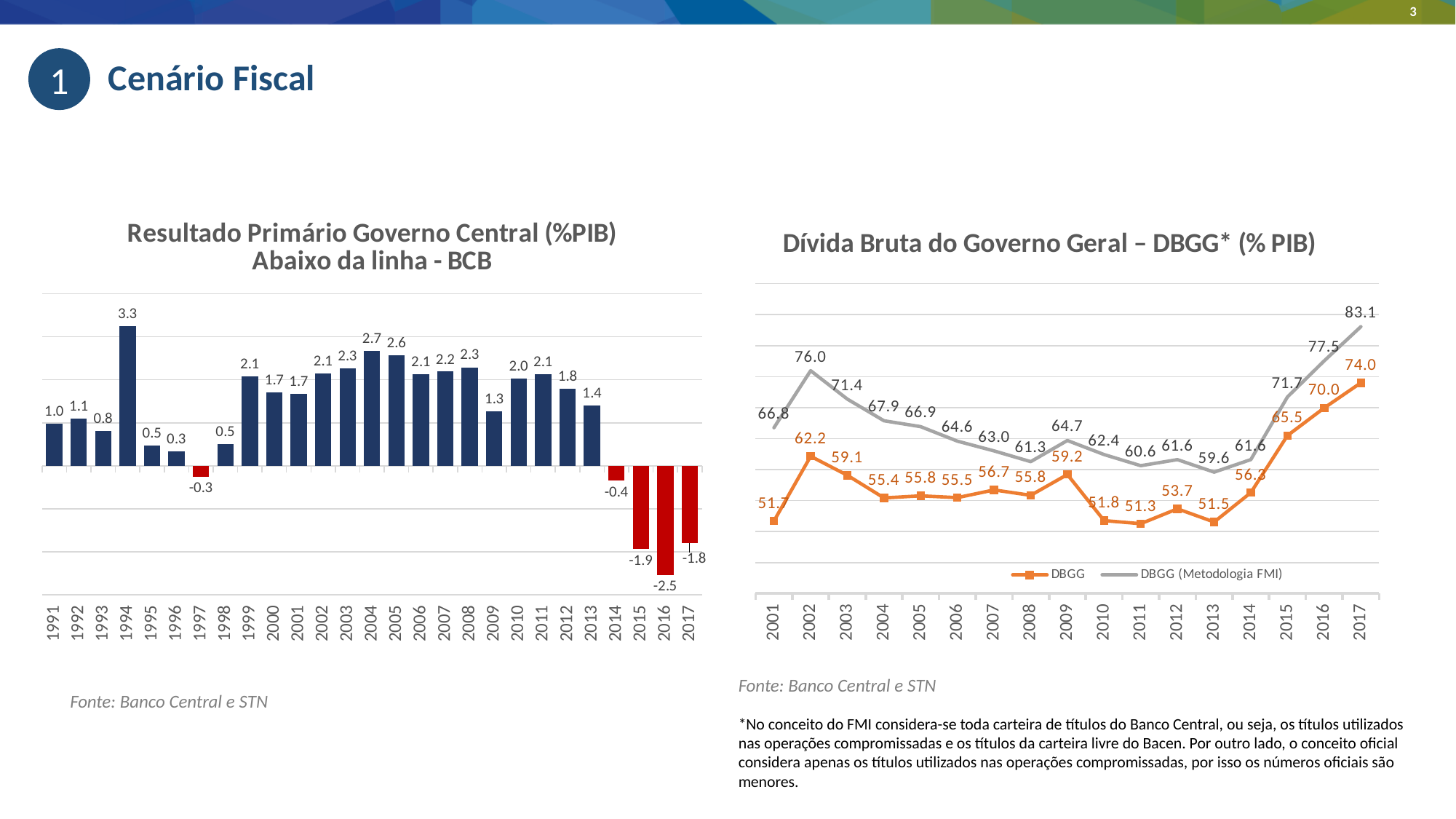
In the 'Resultado Primário Governo Central (%PIB)' chart, which year has the lowest value? 2016 In the 'Dívida Bruta do Governo Geral – DBGG* (% PIB)' chart, do the DBGG values rise or fall from 2013 to 2017? Rise In the 'Resultado Primário Governo Central (%PIB)' chart, what is the difference between the values for 2004 and 2013? 1.3 In the 'Resultado Primário Governo Central (%PIB)' chart, what is the value for 2016? -2.5 In the 'Dívida Bruta do Governo Geral – DBGG* (% PIB)' chart, what is the DBGG value for 2011? 51.3 What kind of chart is the 'Resultado Primário Governo Central (%PIB)' chart? Bar chart In the 'Resultado Primário Governo Central (%PIB)' chart, which year has the highest value? 1994 In the 'Resultado Primário Governo Central (%PIB)' chart, what is the value for 1994? 3.3 In the 'Dívida Bruta do Governo Geral – DBGG* (% PIB)' chart, what is the DBGG (Metodologia FMI) value for 2017? 83.1 In the 'Resultado Primário Governo Central (%PIB)' chart, how many years are shown on the x axis? 27 In the 'Dívida Bruta do Governo Geral – DBGG* (% PIB)' chart, which is larger in 2002: DBGG or DBGG (Metodologia FMI)? DBGG (Metodologia FMI) In the 'Dívida Bruta do Governo Geral – DBGG* (% PIB)' chart, how many series does the legend list? 2